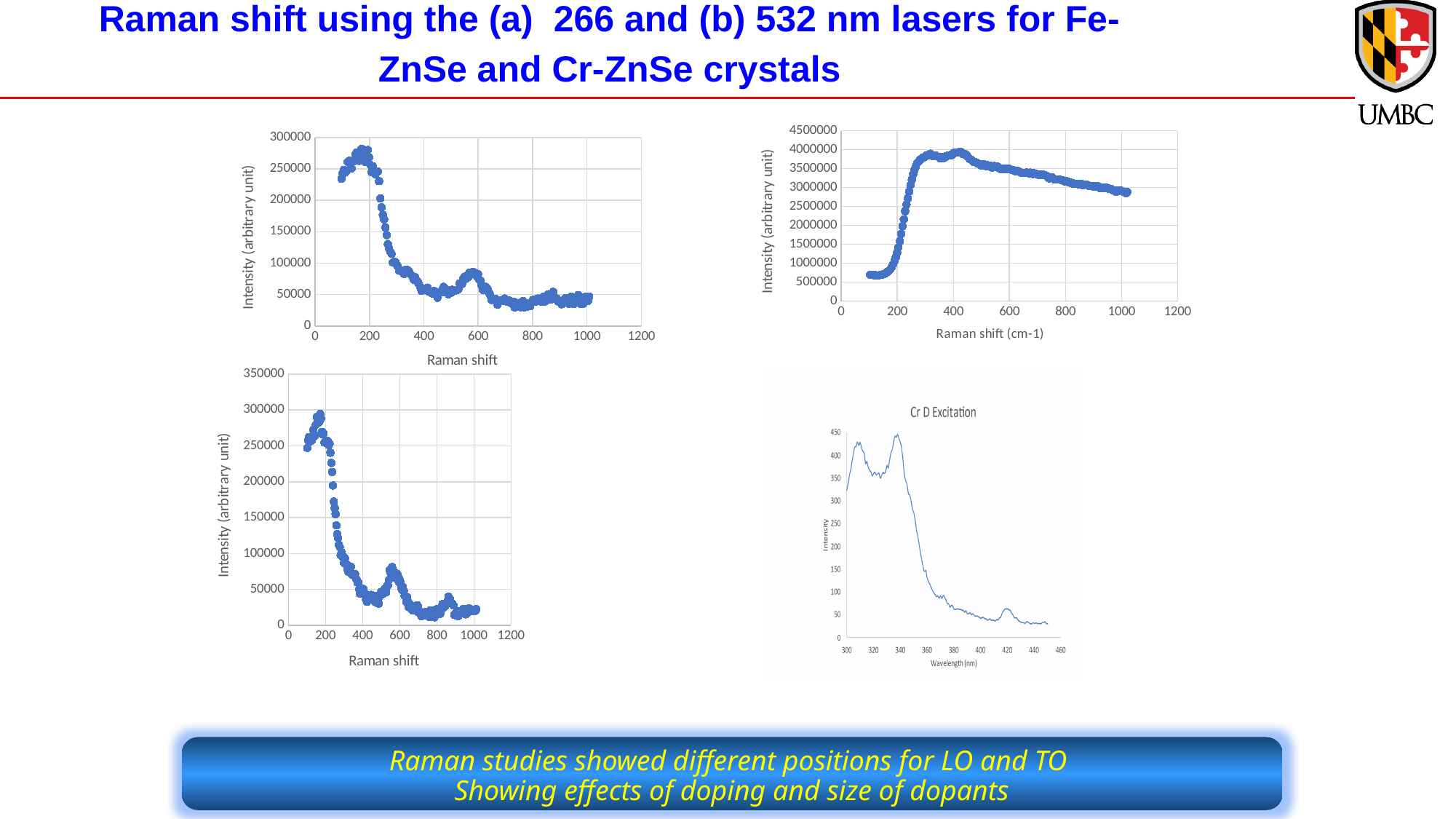
What is the title of the bottom-right chart? Cr D Excitation In the 'Cr D Excitation' chart, does the intensity rise or fall as the wavelength increases from 340 nm to 460 nm? fall In the top-right chart, does the intensity rise or fall as the Raman shift increases from 400 to 1000? fall In the top-left chart, is the intensity at a Raman shift of 200 greater or less than 200000? greater In the top-right chart, is the intensity at a Raman shift of 100 greater or less than 1000000? less In the top-right chart, is the intensity at a Raman shift of 1000 greater or less than 2500000? greater What kind of chart is the bottom-right chart titled 'Cr D Excitation'? line chart What kind of chart is the top-left chart on the slide? scatter chart What is the x-axis label of the top-right chart? Raman shift (cm-1)